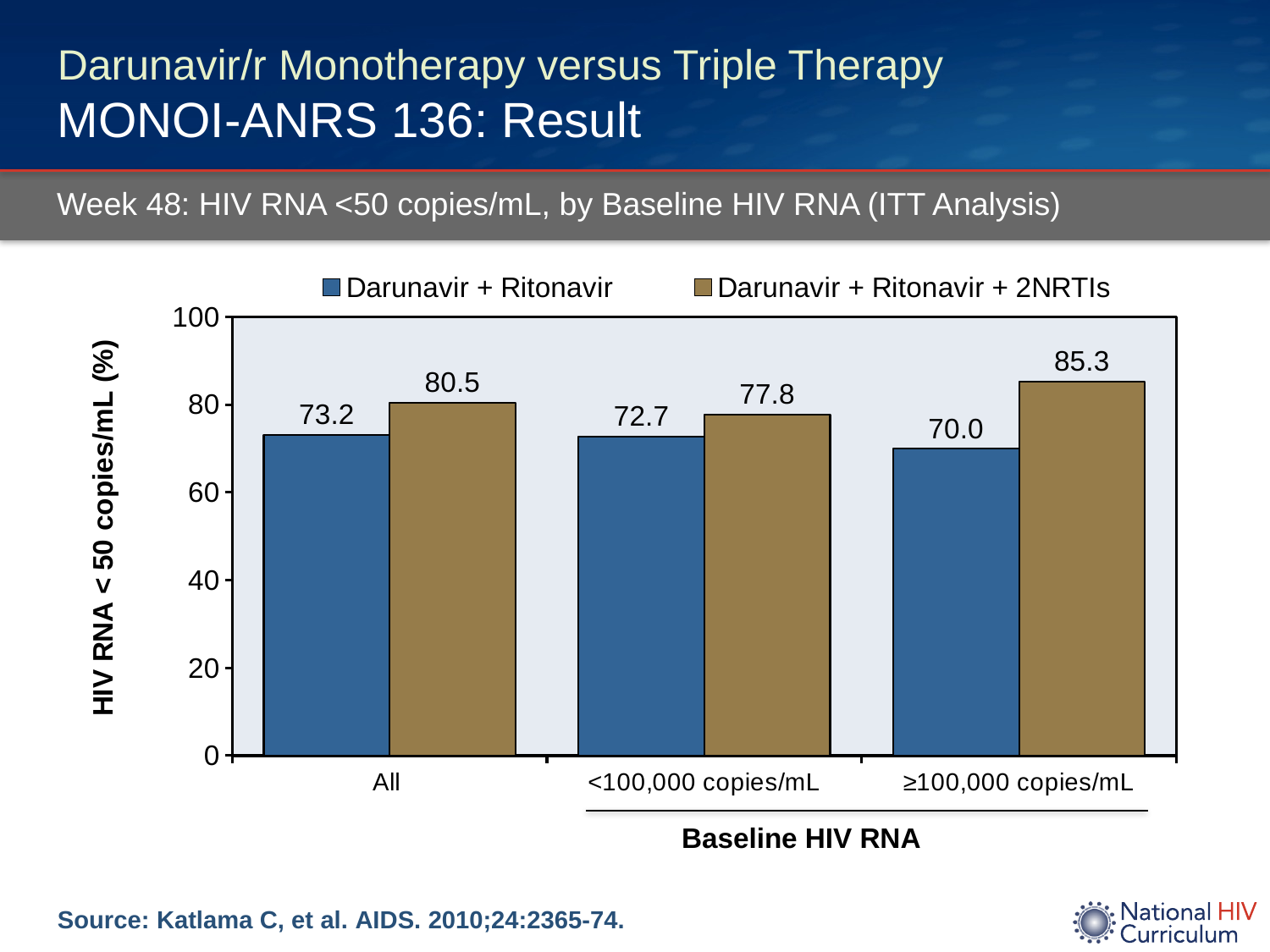
What is the value for Darunavir + Ritonavir in the <100,000 copies/mL category? 72.7 What kind of chart is shown on the slide? bar chart Is the value for Darunavir + Ritonavir in the ≥100,000 copies/mL category greater or less than 80? less What is the value for Darunavir + Ritonavir in the All category? 73.2 How many series does the legend list? 2 Which category has the highest value for Darunavir + Ritonavir + 2NRTIs? ≥100,000 copies/mL How many categories are shown on the x axis? 3 Which category has the lowest value for Darunavir + Ritonavir? ≥100,000 copies/mL What is the difference between Darunavir + Ritonavir + 2NRTIs and Darunavir + Ritonavir in the ≥100,000 copies/mL category? 15.3 In the <100,000 copies/mL category, which series has the larger value? Darunavir + Ritonavir + 2NRTIs What is the value for Darunavir + Ritonavir + 2NRTIs in the ≥100,000 copies/mL category? 85.3 What is the difference between Darunavir + Ritonavir + 2NRTIs and Darunavir + Ritonavir in the All category? 7.3